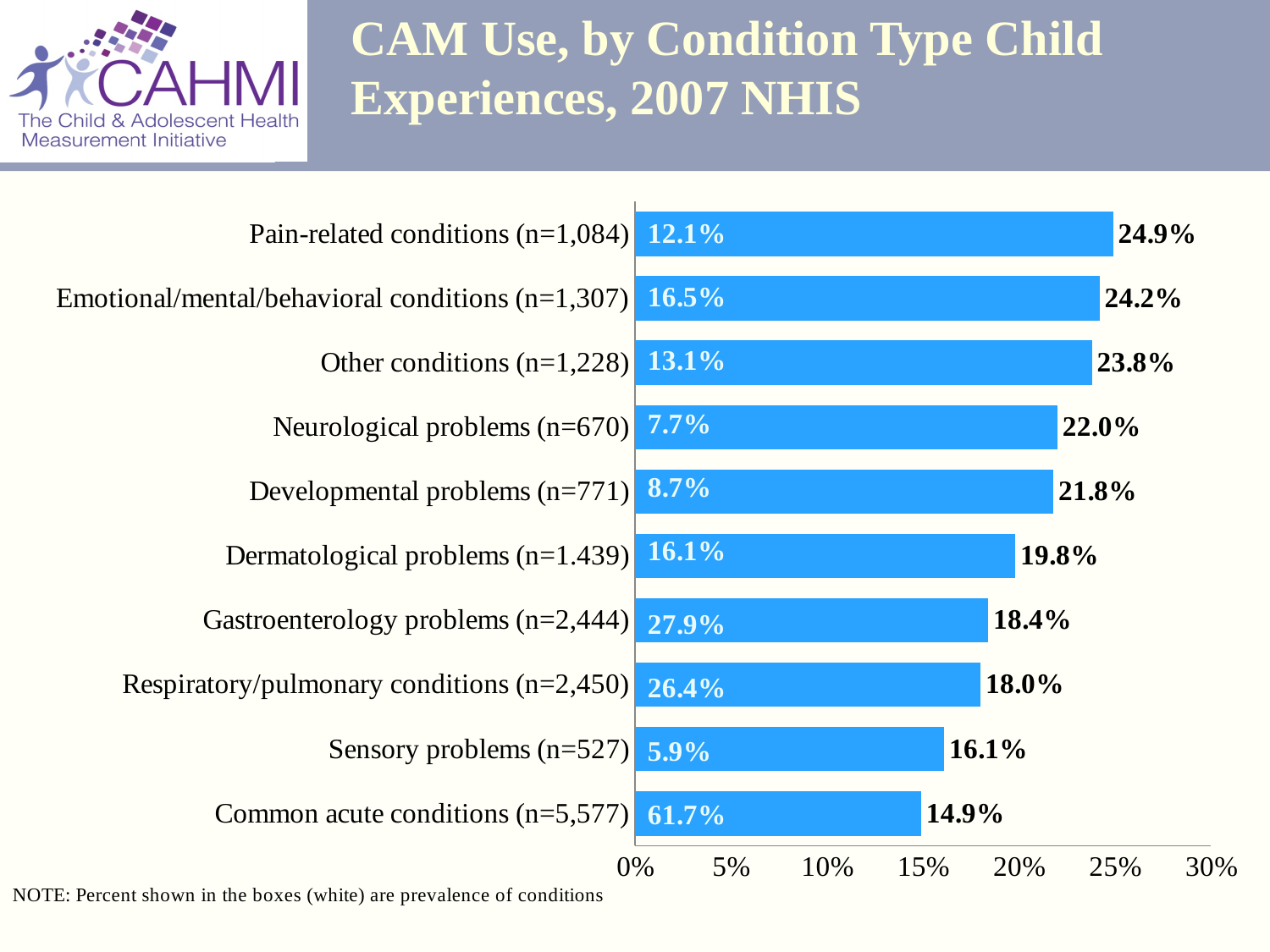
Which has a higher CAM use percentage: Neurological problems or Gastroenterology problems? Neurological problems What is the CAM use percentage for Sensory problems (n=527)? 16.1% How many condition types are shown in the chart? 10 What type of chart is shown on the slide? Bar chart What is the maximum value shown on the horizontal axis? 30% According to the note, what do the white percentages in the boxes represent? Prevalence of conditions What prevalence percentage is shown in the white box for Common acute conditions (n=5,577)? 61.7% Which condition type has the highest CAM use percentage? Pain-related conditions (n=1,084) What is the CAM use percentage for Pain-related conditions (n=1,084)? 24.9% Is the CAM use value for Dermatological problems greater or less than 15%? greater What is the difference in CAM use between Pain-related conditions and Common acute conditions? 10.0% Which condition type has the lowest CAM use percentage? Common acute conditions (n=5,577)